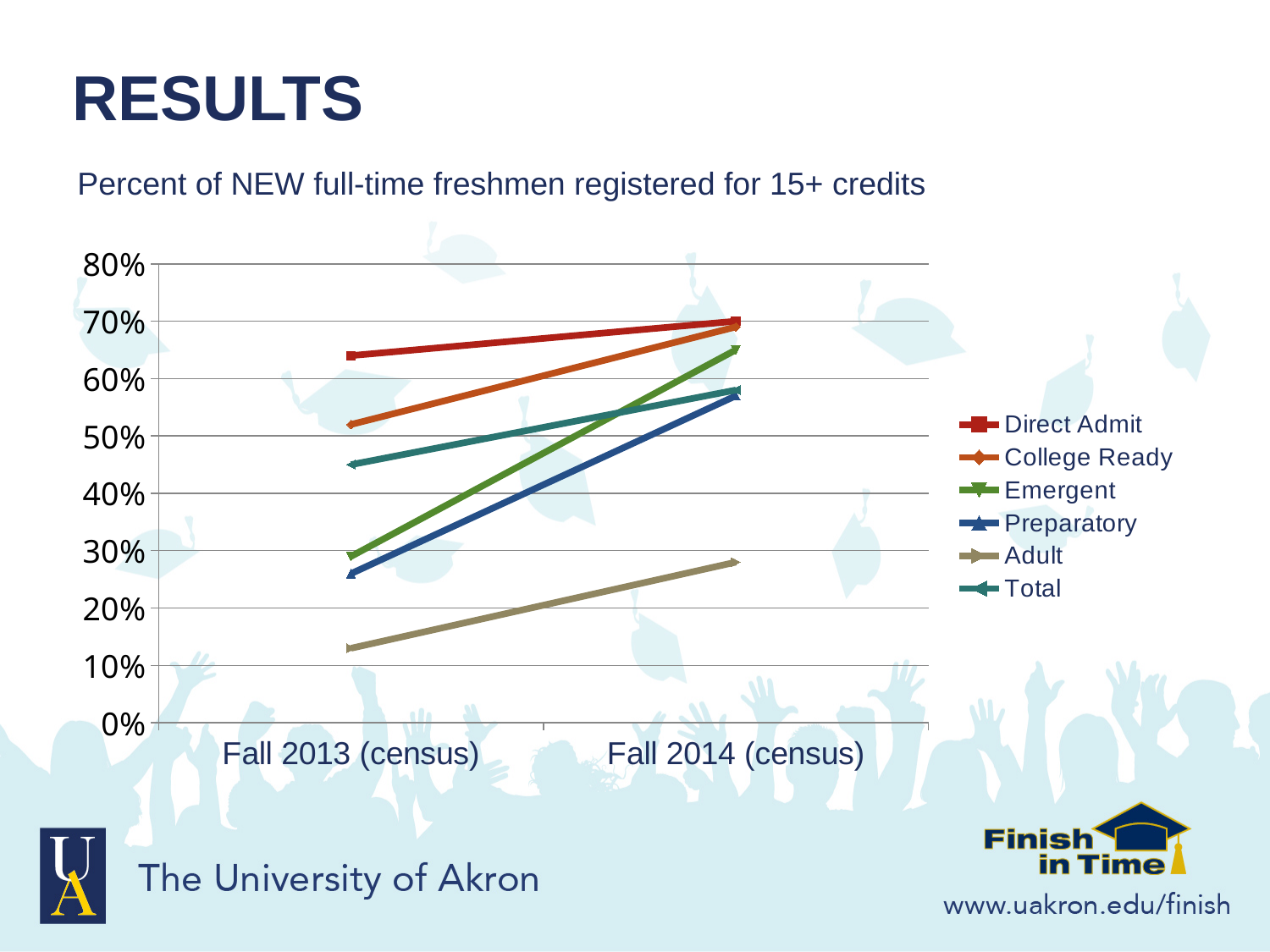
Does the Adult series rise or fall from Fall 2013 (census) to Fall 2014 (census)? rise How many time points are plotted along the x axis? 2 Is the value for Adult in Fall 2013 (census) greater or less than 20%? less Is the value for Total in Fall 2013 (census) greater or less than 50%? less Which series has the lowest value in Fall 2013 (census)? Adult How many series does the legend list? 6 What kind of chart is shown on the slide? line chart Is the value for Direct Admit in Fall 2013 (census) greater or less than 60%? greater Which series has the lowest value in Fall 2014 (census)? Adult What is the title of the chart? Percent of NEW full-time freshmen registered for 15+ credits In Fall 2014 (census), which is larger, Emergent or Preparatory? Emergent Which series has the highest value in Fall 2013 (census)? Direct Admit